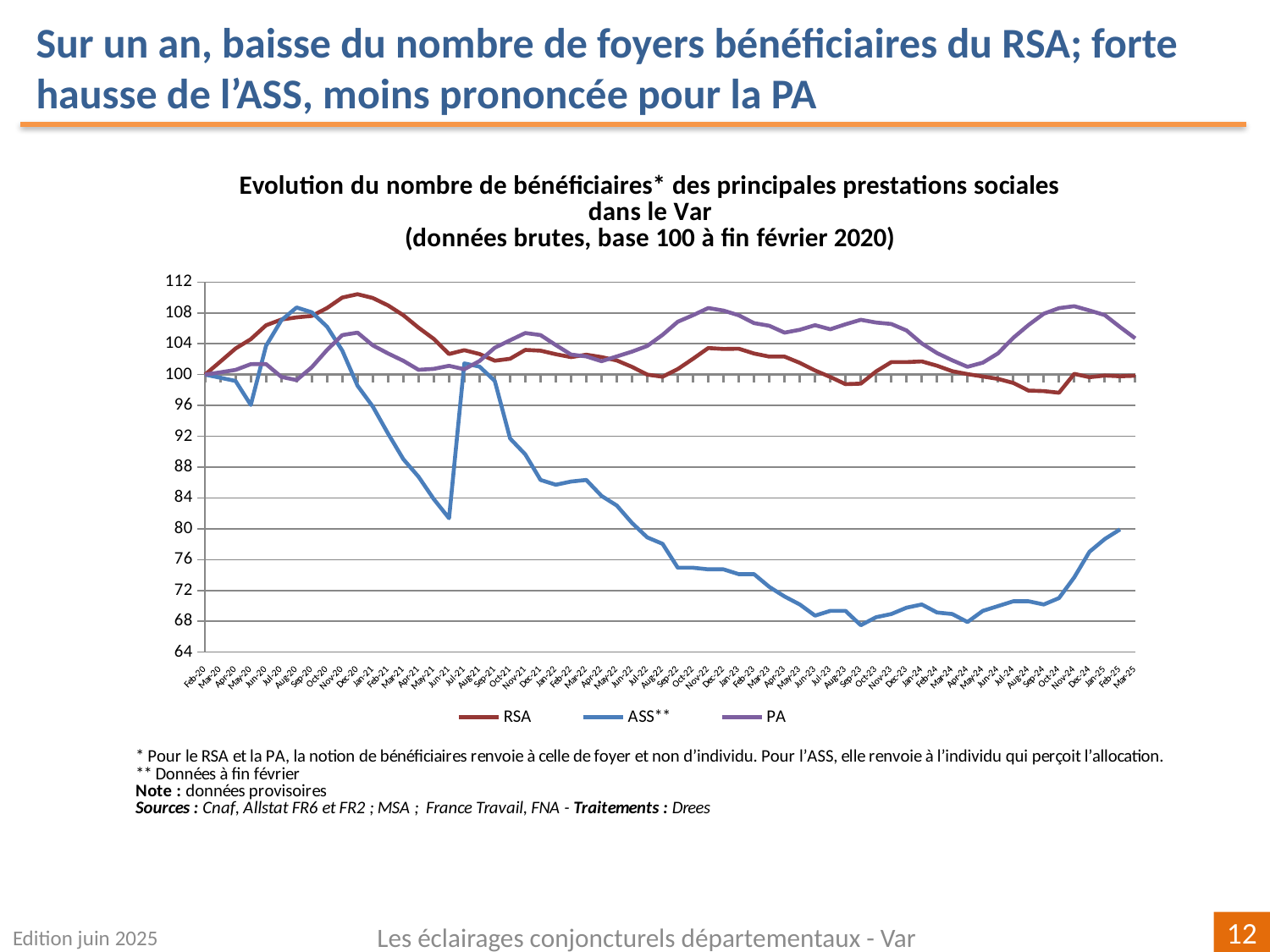
How many series does the legend list? 3 What kind of chart is shown on the slide? line chart Is the value for ASS** in Jun-23 greater or less than 72? less What is the value of all three series at Feb-20, the base month? 100 Is the value for PA in Oct-22 greater or less than 104? greater Is the value for RSA in Sep-24 greater or less than 100? less Which series has the lowest value in Jun-23? ASS** What are the three series named in the legend? RSA, ASS**, PA